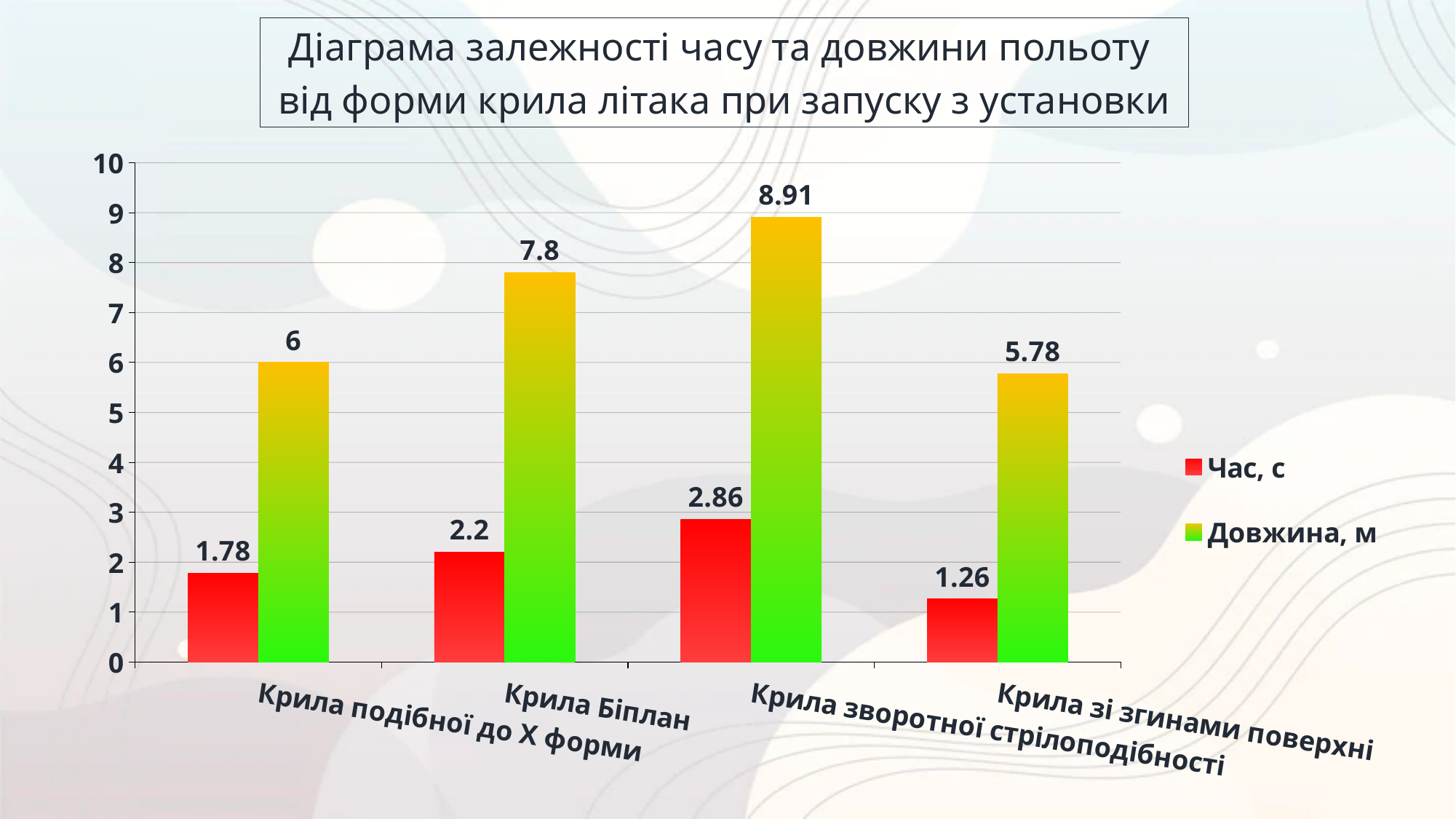
What is the difference between the "Довжина, м" values for "Крила зворотної стрілоподібності" and "Крила Біплан"? 1.11 What is the difference between the "Час, с" values for "Крила зворотної стрілоподібності" and "Крила подібної до Х форми"? 1.08 What is the value of "Довжина, м" for "Крила подібної до Х форми"? 6 What is the value of "Довжина, м" for "Крила зі згинами поверхні"? 5.78 What is the value of "Час, с" for "Крила Біплан"? 2.2 Which category has the lowest value for "Час, с"? Крила зі згинами поверхні What kind of chart is shown on the slide? bar chart How many series does the legend list? 2 Is the value of "Довжина, м" for "Крила Біплан" greater or less than 7? greater How many categories are shown on the x axis? 4 Which is larger: the "Час, с" value for "Крила Біплан" or for "Крила зі згинами поверхні"? Крила Біплан Which category has the highest value for "Довжина, м"? Крила зворотної стрілоподібності